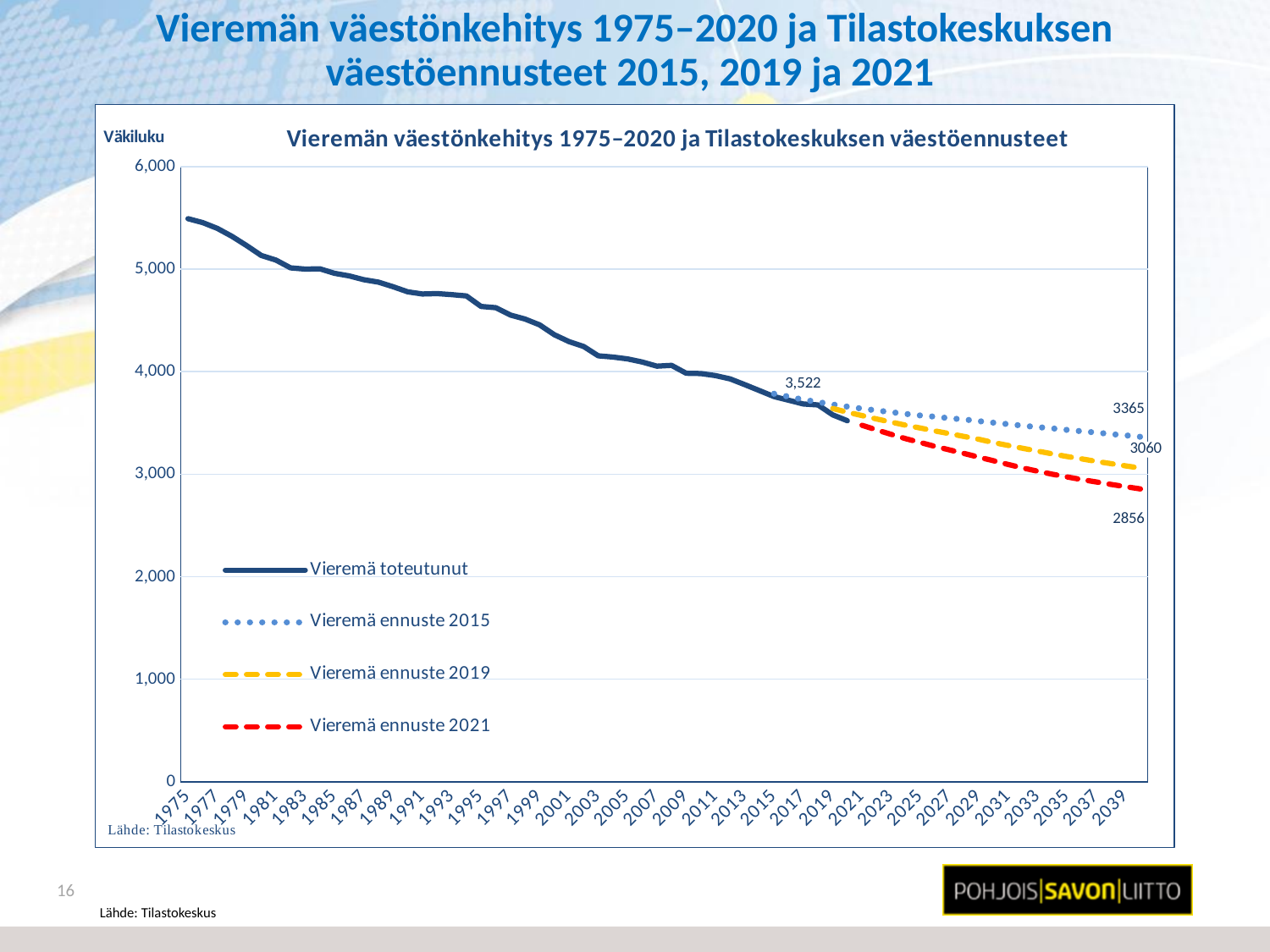
Does the Vieremä toteutunut series rise or fall from 1975 to 2020? fall How many series does the chart legend list? 4 Which forecast series ends at the highest labelled value? Vieremä ennuste 2015 What is the label on the vertical axis of the chart? Väkiluku What is the labelled end value of the Vieremä ennuste 2015 series? 3365 Is the value of Vieremä toteutunut in 1975 greater or less than 5,000? greater What is the difference between the labelled end values of Vieremä ennuste 2019 and Vieremä ennuste 2021? 204 What is the labelled end value of the Vieremä ennuste 2021 series? 2856 Which forecast series ends at the lowest labelled value? Vieremä ennuste 2021 What is the labelled end value of the Vieremä ennuste 2019 series? 3060 What is the difference between the labelled end values of Vieremä ennuste 2015 and Vieremä ennuste 2021? 509 What kind of chart is shown on the slide? line chart